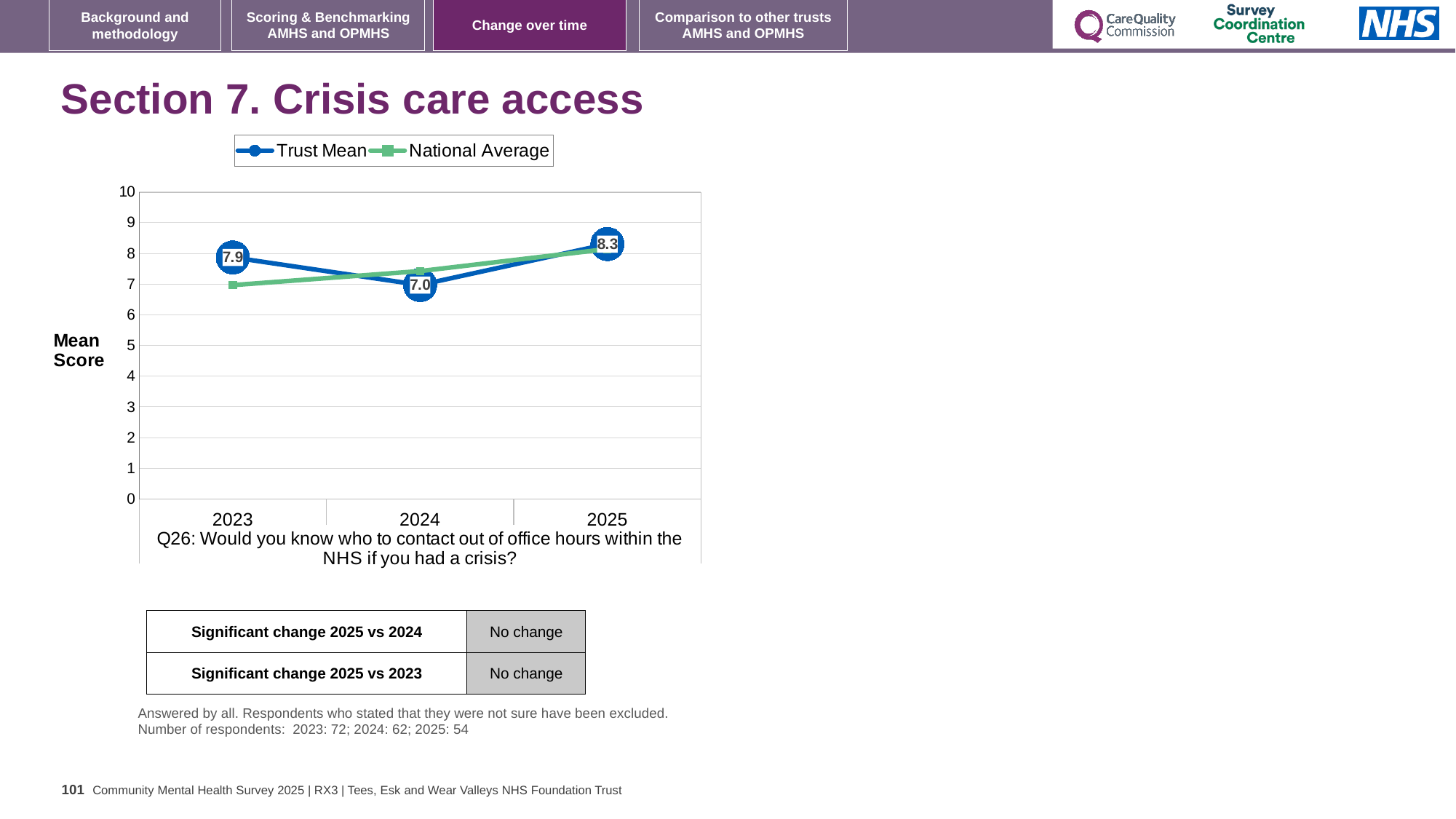
In 2023, which is higher: the Trust Mean or the National Average? Trust Mean How many series does the chart legend list? 2 What is the Trust Mean score for 2025? 8.3 What is the Trust Mean score for 2023? 7.9 In which year is the Trust Mean highest? 2025 In which year is the Trust Mean lowest? 2024 What is the difference between the Trust Mean in 2025 and in 2024? 1.3 Is the National Average value for 2024 greater or less than 8? less How many years are shown on the x axis of the chart? 3 What is the Trust Mean score for 2024? 7.0 What kind of chart is shown on the slide? Line chart In 2024, which is higher: the Trust Mean or the National Average? National Average